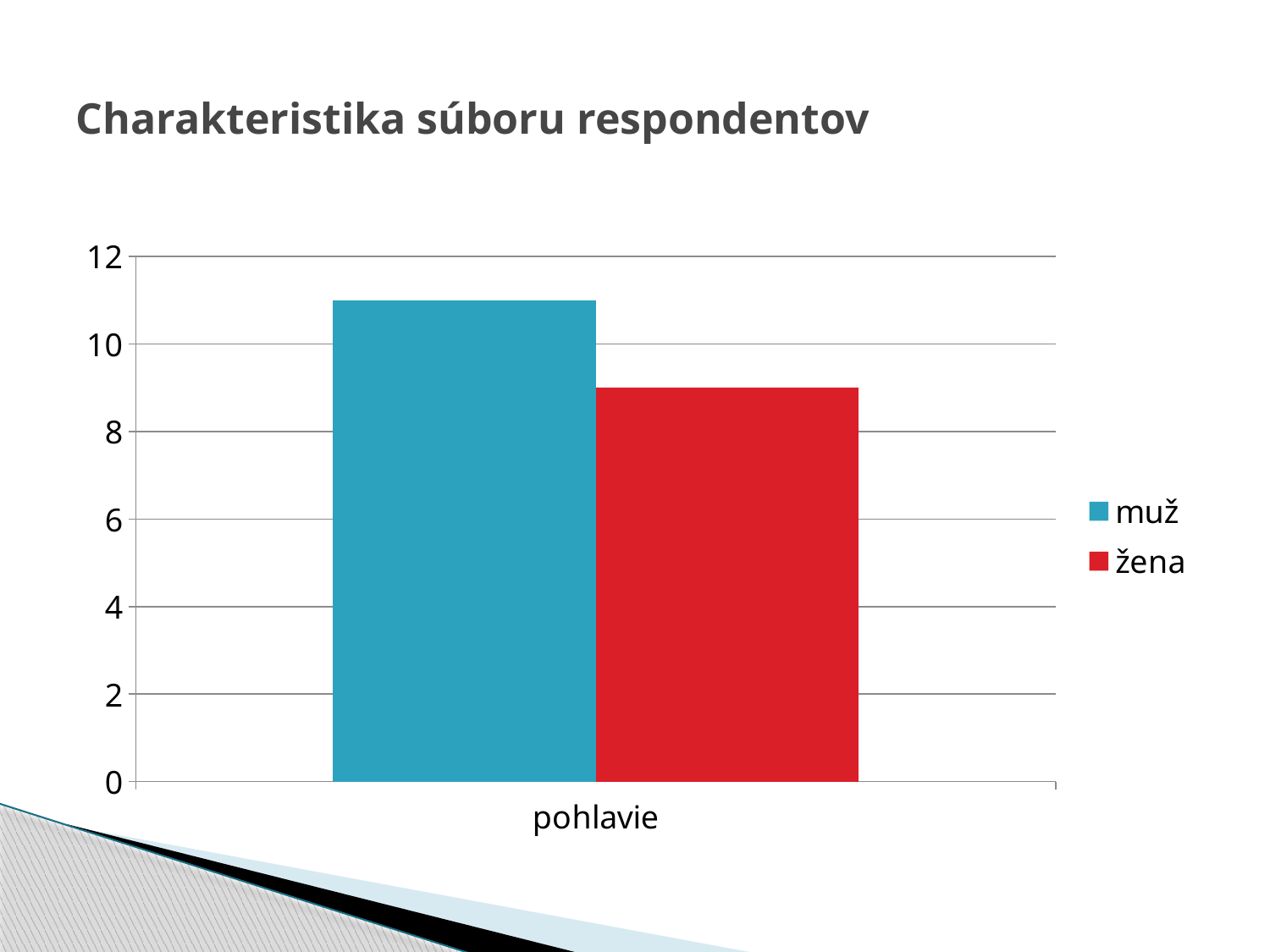
How many series does the legend list? 2 How many categories are shown on the x axis? 1 Which series has the taller bar, muž or žena? muž What kind of chart is shown on the slide? bar chart Is the value for žena greater or less than 8? greater Which series has the highest value? muž What is the title of the slide? Charakteristika súboru respondentov Is the value for žena greater or less than 10? less Is the value for muž greater or less than 10? greater What is the label of the category on the x axis? pohlavie Which series has the lowest value? žena